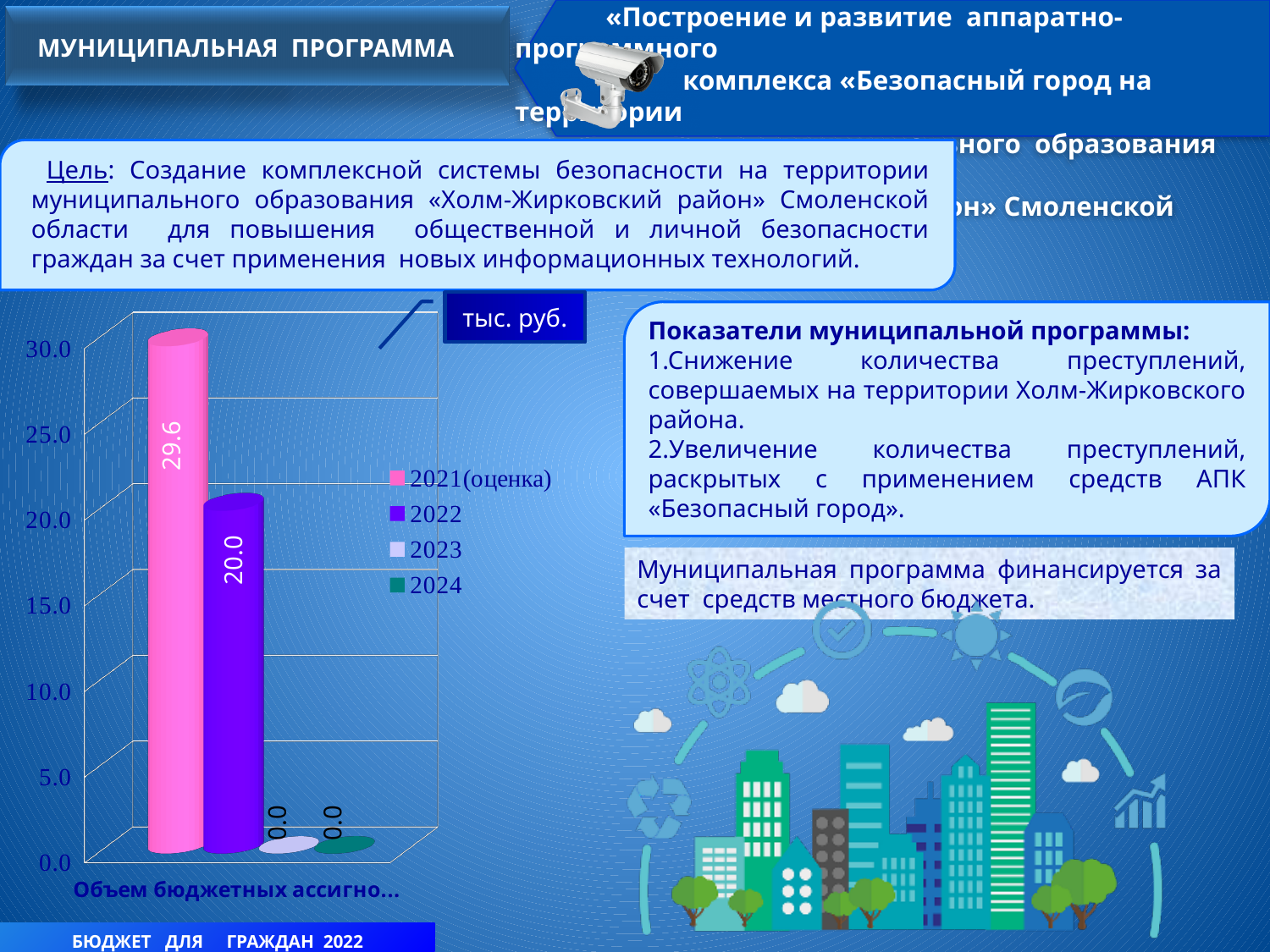
What is the difference between the 2021(оценка) value and the 2022 value? 9.6 Is the value for 2022 greater or less than 25.0? less What is the value for the 2022 series in the chart? 20.0 What is the value for the 2021(оценка) series in the chart? 29.6 What is the value for the 2023 series in the chart? 0.0 Which is larger, the value for 2021(оценка) or the value for 2022? 2021(оценка) How many series does the legend list? 4 Which series has the highest value in the chart? 2021(оценка) What kind of chart is shown on the slide? bar chart Is the value for 2021(оценка) greater or less than 25.0? greater What unit is shown in the box above the chart? тыс. руб. What is the value for the 2024 series in the chart? 0.0